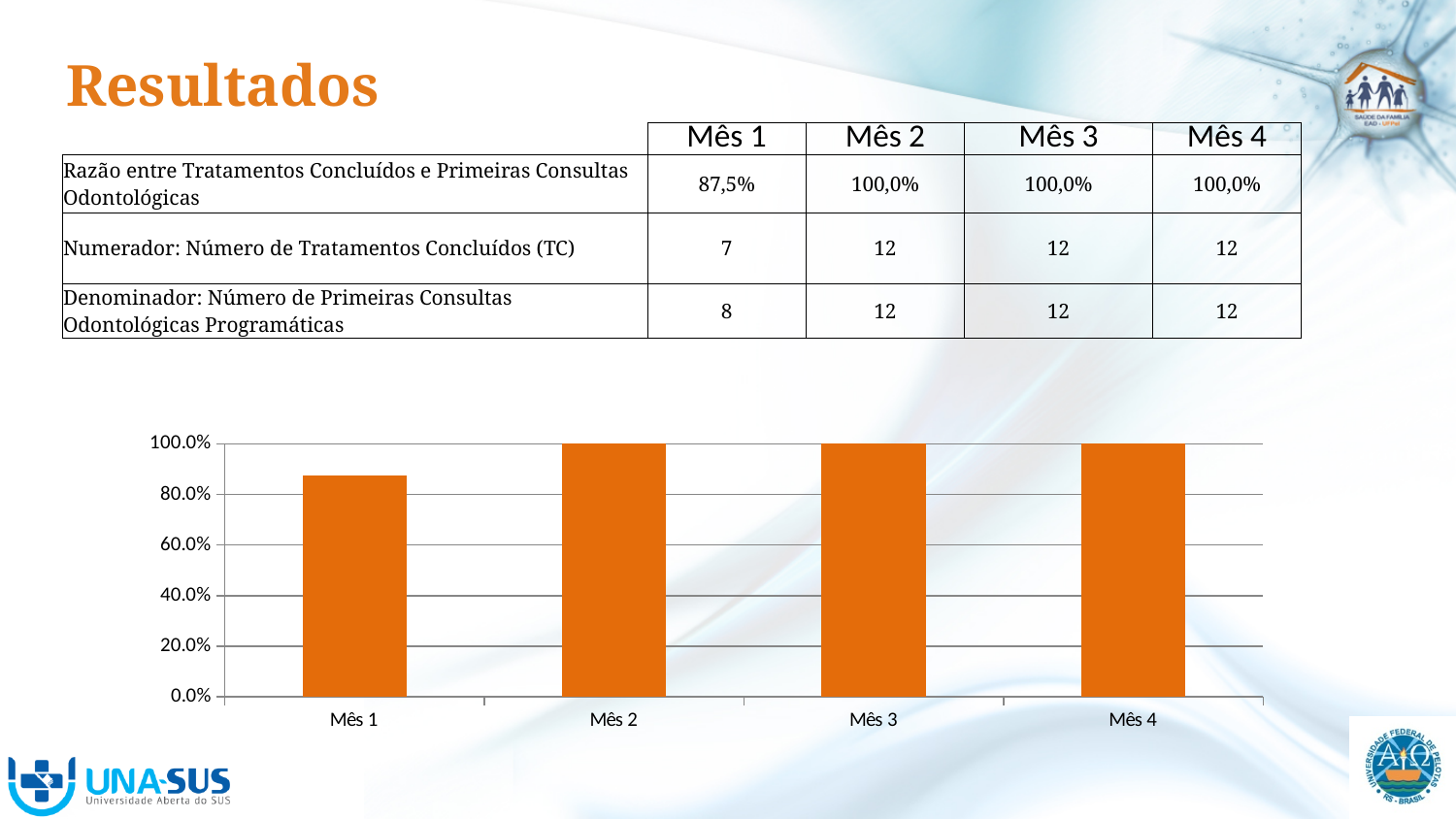
What is the value of the bar for Mês 4? 100.0% Do the values change between Mês 2 and Mês 4? No, they stay the same Is the value for Mês 1 greater or less than 80.0%? greater Which month has the lowest bar in the chart? Mês 1 What kind of chart is shown on the slide? bar chart Which is larger, the bar for Mês 1 or the bar for Mês 3? Mês 3 Is the value for Mês 1 greater or less than 100.0%? less What colour are the bars in the chart? orange What is the value of the bar for Mês 2? 100.0% Do the values rise or fall from Mês 1 to Mês 2? rise How many categories (months) are plotted on the x axis of the chart? 4 What is the highest value shown on the chart's y axis? 100.0%